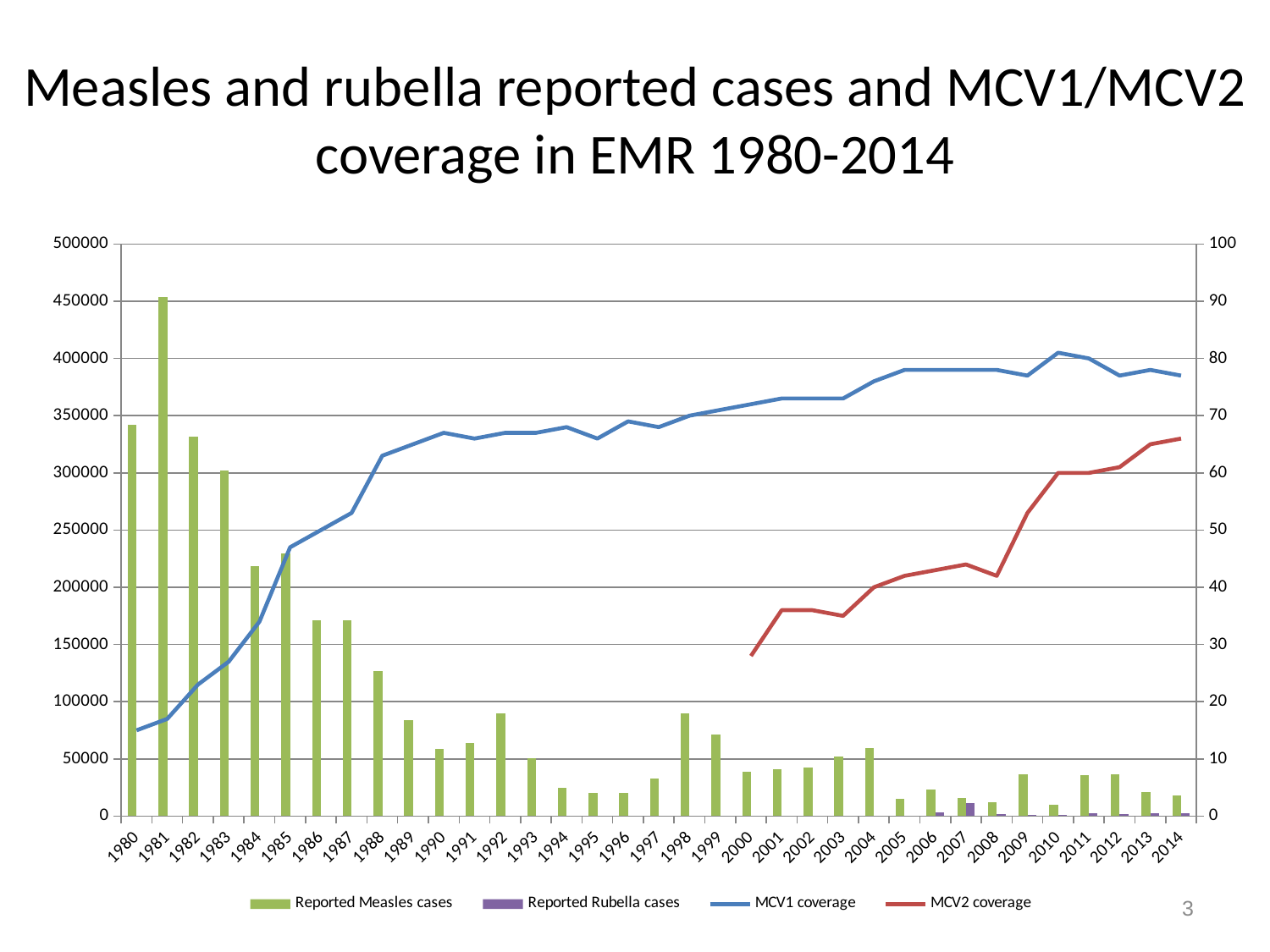
In which year were reported measles cases highest? 1981 Does MCV1 coverage generally rise or fall from 1980 to 2014? rise Is the number of reported measles cases in 1988 greater or less than 150000? less What kind of chart is shown on the slide? A combination bar and line chart In which year was MCV2 coverage highest? 2014 Is MCV2 coverage in 2014 greater or less than 60? greater Which year had more reported measles cases, 1981 or 1983? 1981 In which year was MCV1 coverage lowest? 1980 Is the number of reported measles cases in 1981 greater or less than 400000? greater How many series does the legend list? 4 What is the title of the chart? Measles and rubella reported cases and MCV1/MCV2 coverage in EMR 1980-2014 How many years are shown along the x axis? 35